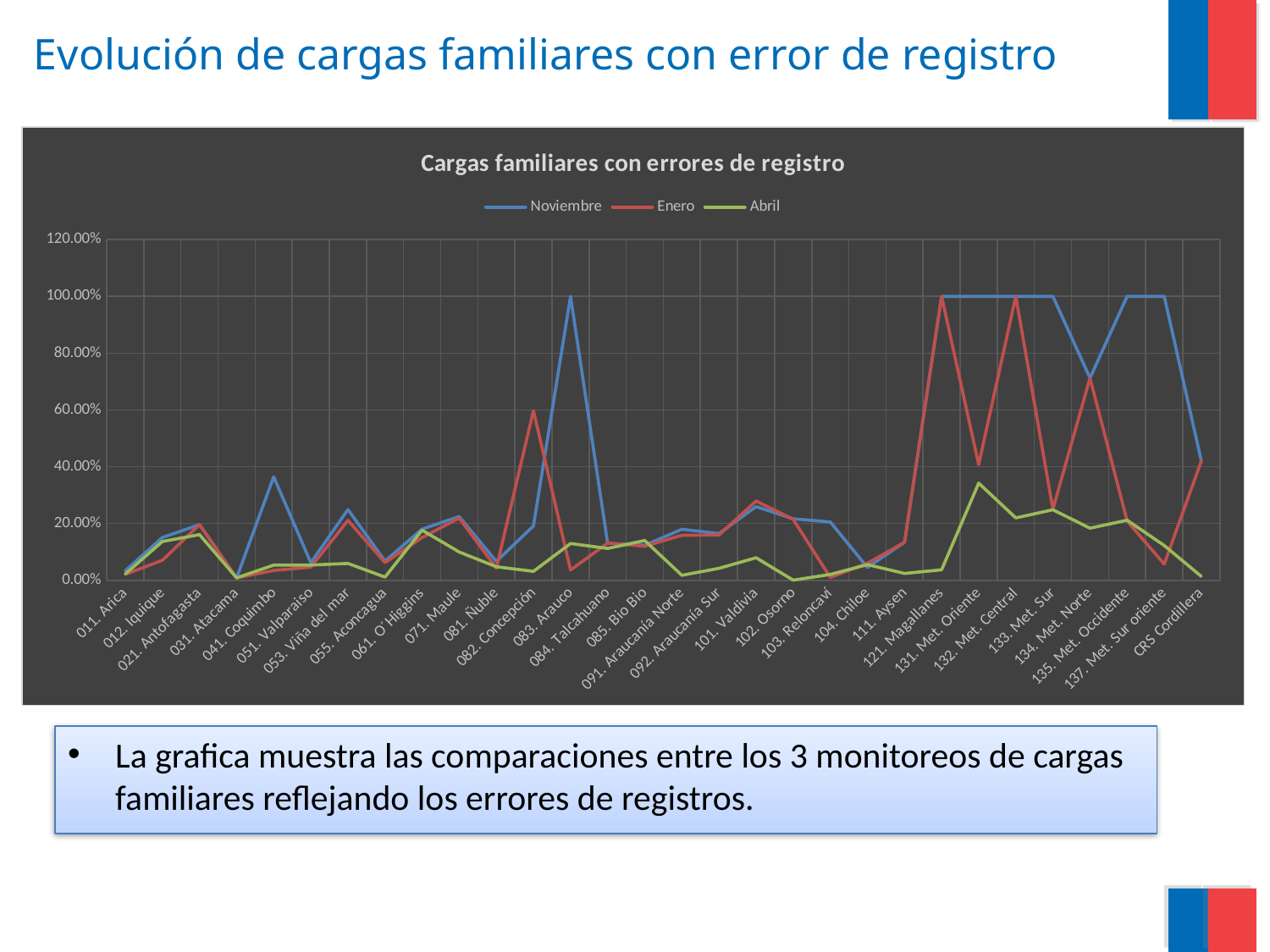
Is the Abril value for 131. Met. Oriente greater or less than 20.00%? greater Is the Enero value for 082. Concepción greater or less than 40.00%? greater For the Abril series, which category has the highest value? 131. Met. Oriente What kind of chart is shown on the slide? Line chart How many series does the legend list? 3 At 082. Concepción, which series has the larger value, Enero or Noviembre? Enero Is the Noviembre value for 041. Coquimbo greater or less than 20.00%? greater What are the three series named in the legend? Noviembre, Enero, Abril How many categories are shown along the x axis? 30 What is the title of the chart? Cargas familiares con errores de registro What is the Noviembre value for 083. Arauco? 100.00%